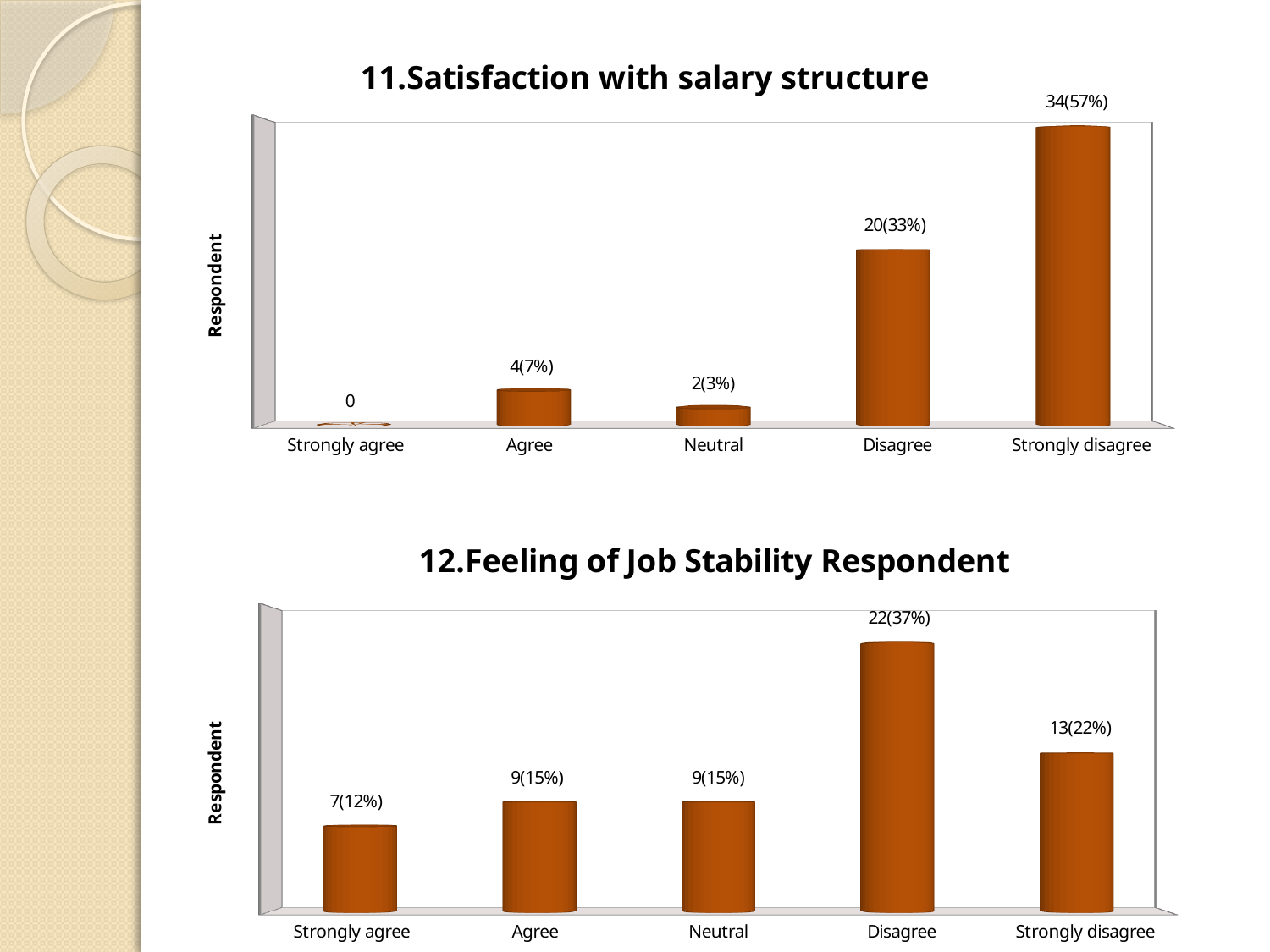
In the '11.Satisfaction with salary structure' chart, which category has the highest value? Strongly disagree In the '12.Feeling of Job Stability Respondent' chart, what is the data label for Strongly agree? 7(12%) In the '11.Satisfaction with salary structure' chart, what is the data label for Strongly disagree? 34(57%) What kind of chart is the '11.Satisfaction with salary structure' chart? Bar chart In the '11.Satisfaction with salary structure' chart, how many more respondents chose Disagree than Agree? 16 In the '11.Satisfaction with salary structure' chart, what is the data label for Disagree? 20(33%) In the '12.Feeling of Job Stability Respondent' chart, what is the data label for Disagree? 22(37%) In the '12.Feeling of Job Stability Respondent' chart, which is larger, Strongly disagree or Neutral? Strongly disagree In the '12.Feeling of Job Stability Respondent' chart, which category has the highest value? Disagree What is the y-axis label of the '12.Feeling of Job Stability Respondent' chart? Respondent In the '12.Feeling of Job Stability Respondent' chart, how many categories are shown on the x axis? 5 In the '11.Satisfaction with salary structure' chart, which category has the lowest value? Strongly agree